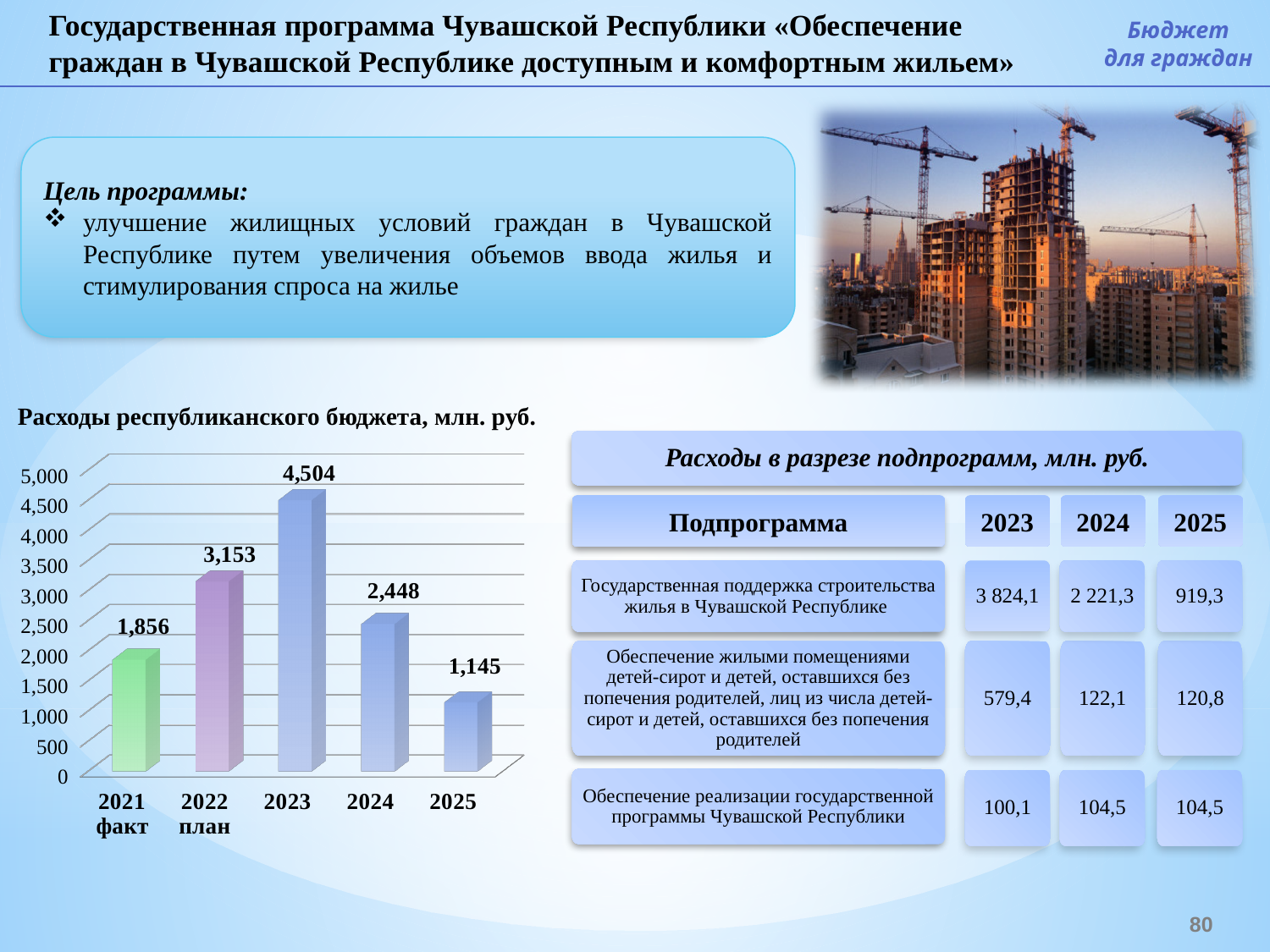
Which year has the highest value in the chart? 2023 What kind of chart is shown on the slide? bar chart What is the value for 2021 факт in the chart? 1,856 What is the difference between the values for 2023 and 2024 in the chart? 2,056 What is the difference between the values for 2022 план and 2021 факт in the chart? 1,297 Which year has the lowest value in the chart? 2025 What is the value for 2023 in the chart "Расходы республиканского бюджета, млн. руб."? 4,504 Is the value for 2024 in the chart greater or less than 2,000? greater How many years (categories) are shown in the chart? 5 Which is larger in the chart: the value for 2022 план or the value for 2024? 2022 план What is the title of the chart on the slide? Расходы республиканского бюджета, млн. руб. What is the value for 2025 in the chart? 1,145